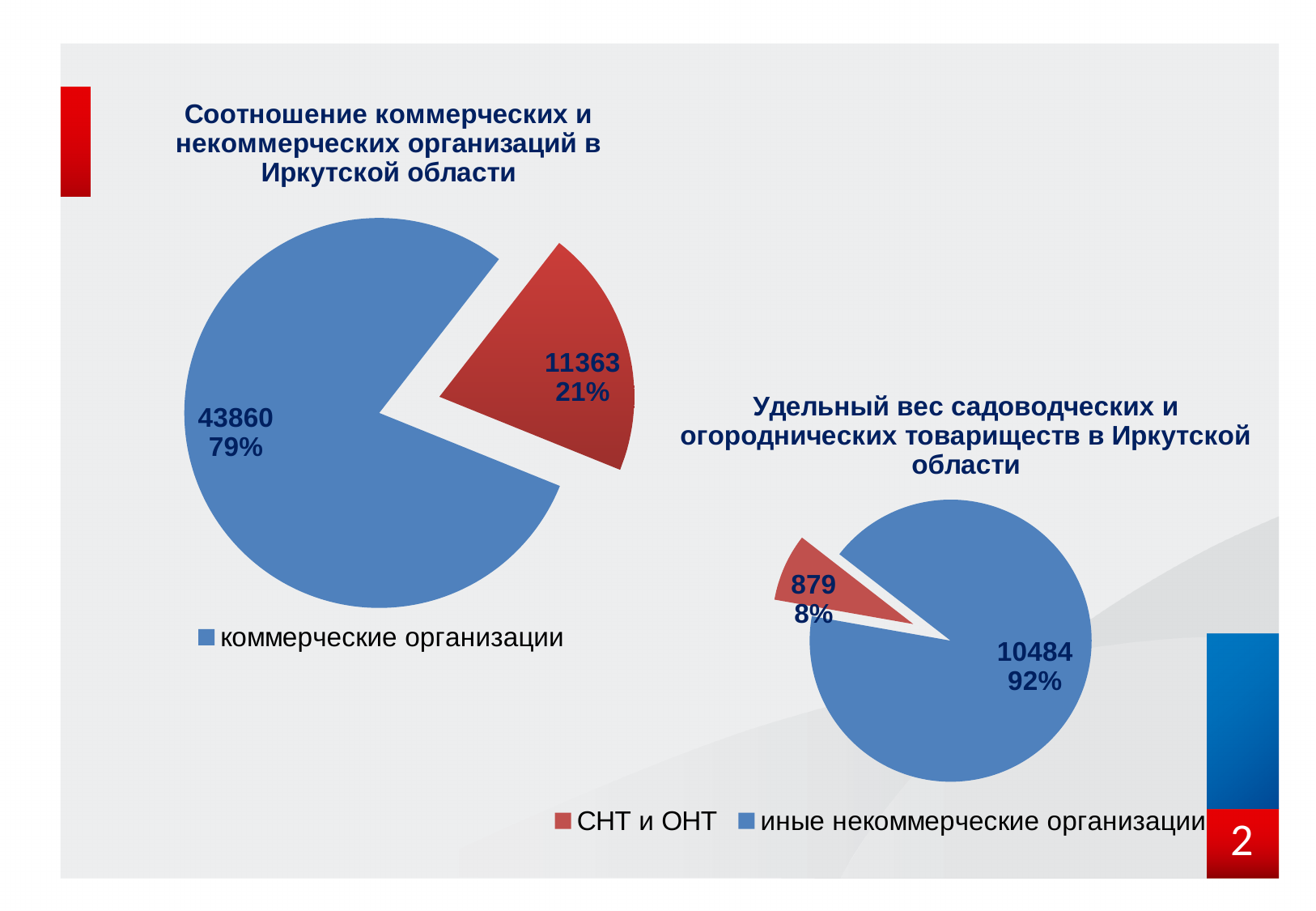
In the left chart (Соотношение коммерческих и некоммерческих организаций в Иркутской области), what is the difference between the two slice values, 43860 and 11363? 32497 In the left chart (Соотношение коммерческих и некоммерческих организаций в Иркутской области), what percentage is printed on the red slice? 21% In the left chart (Соотношение коммерческих и некоммерческих организаций в Иркутской области), what share of the pie do коммерческие организации make up? 79% In the left chart (Соотношение коммерческих и некоммерческих организаций в Иркутской области), what value is printed on the red slice? 11363 In the right chart (Удельный вес садоводческих и огороднических товариществ в Иркутской области), what is the total of the two slice values, 879 and 10484? 11363 In the left chart (Соотношение коммерческих и некоммерческих организаций в Иркутской области), what value is shown for коммерческие организации? 43860 In the right chart (Удельный вес садоводческих и огороднических товариществ в Иркутской области), what value is shown for иные некоммерческие организации? 10484 In the right chart (Удельный вес садоводческих и огороднических товариществ в Иркутской области), what share of the pie do СНТ и ОНТ make up? 8% What type of chart is used for both charts on the slide? Pie chart In the right chart (Удельный вес садоводческих и огороднических товариществ в Иркутской области), which slice is larger: СНТ и ОНТ or иные некоммерческие организации? иные некоммерческие организации In the right chart (Удельный вес садоводческих и огороднических товариществ в Иркутской области), what value is shown for СНТ и ОНТ? 879 How many entries does the legend of the right chart (Удельный вес садоводческих и огороднических товариществ в Иркутской области) list? 2